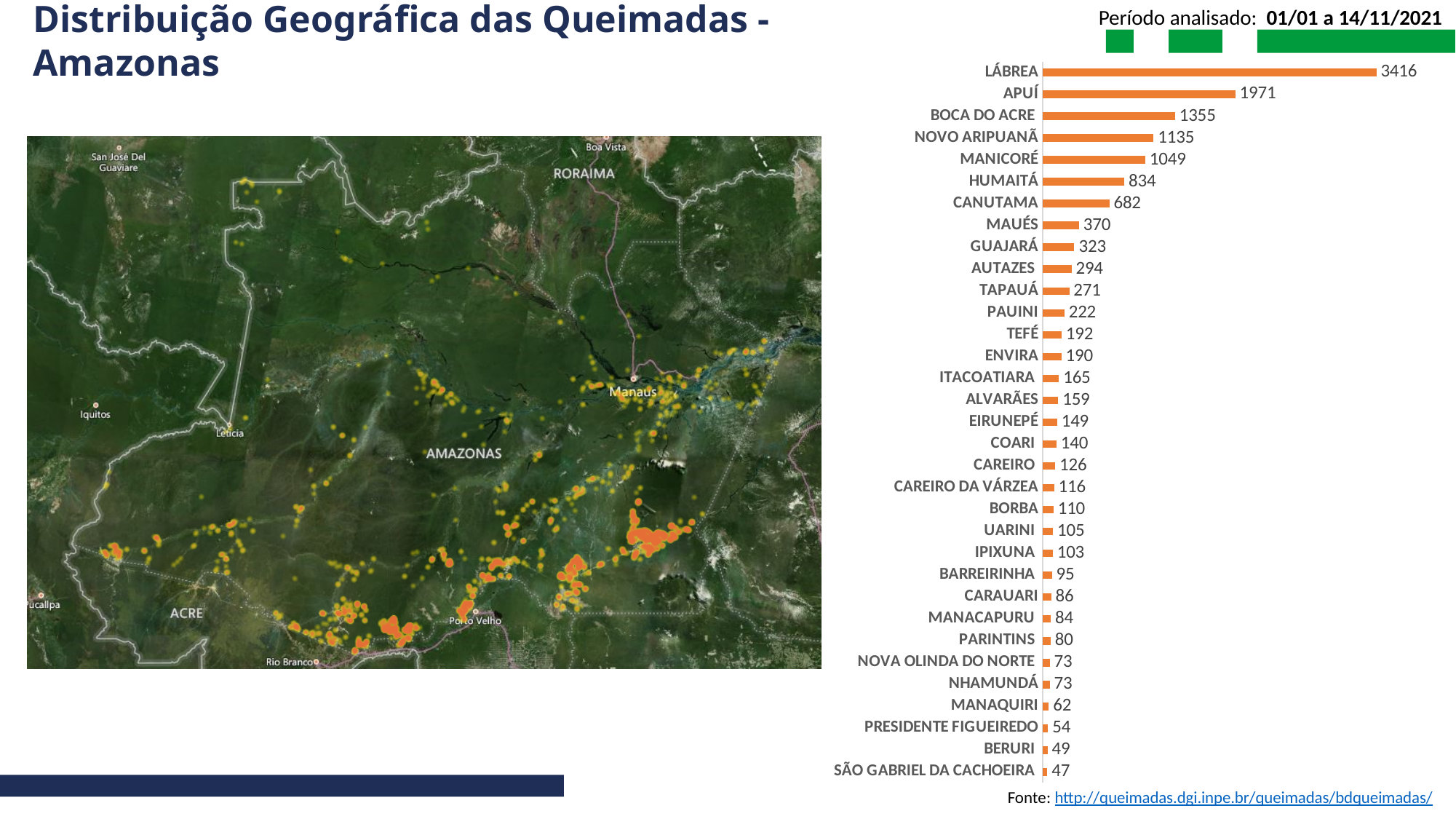
Which has a larger value, TEFÉ or ITACOATIARA? TEFÉ What is the difference between the values for BOCA DO ACRE and NOVO ARIPUANÃ? 220 What is the value for COARI in the bar chart? 140 What kind of chart is shown on the right of the slide? bar chart What is the value for HUMAITÁ in the bar chart? 834 How many municipalities are shown in the bar chart? 33 What period is analysed according to the slide? 01/01 a 14/11/2021 What is the value for LÁBREA in the bar chart? 3416 Which municipality has the lowest value in the bar chart? SÃO GABRIEL DA CACHOEIRA Which has a larger value, MANICORÉ or CANUTAMA? MANICORÉ Which municipality has the highest value in the bar chart? LÁBREA What is the difference between the values for LÁBREA and APUÍ? 1445